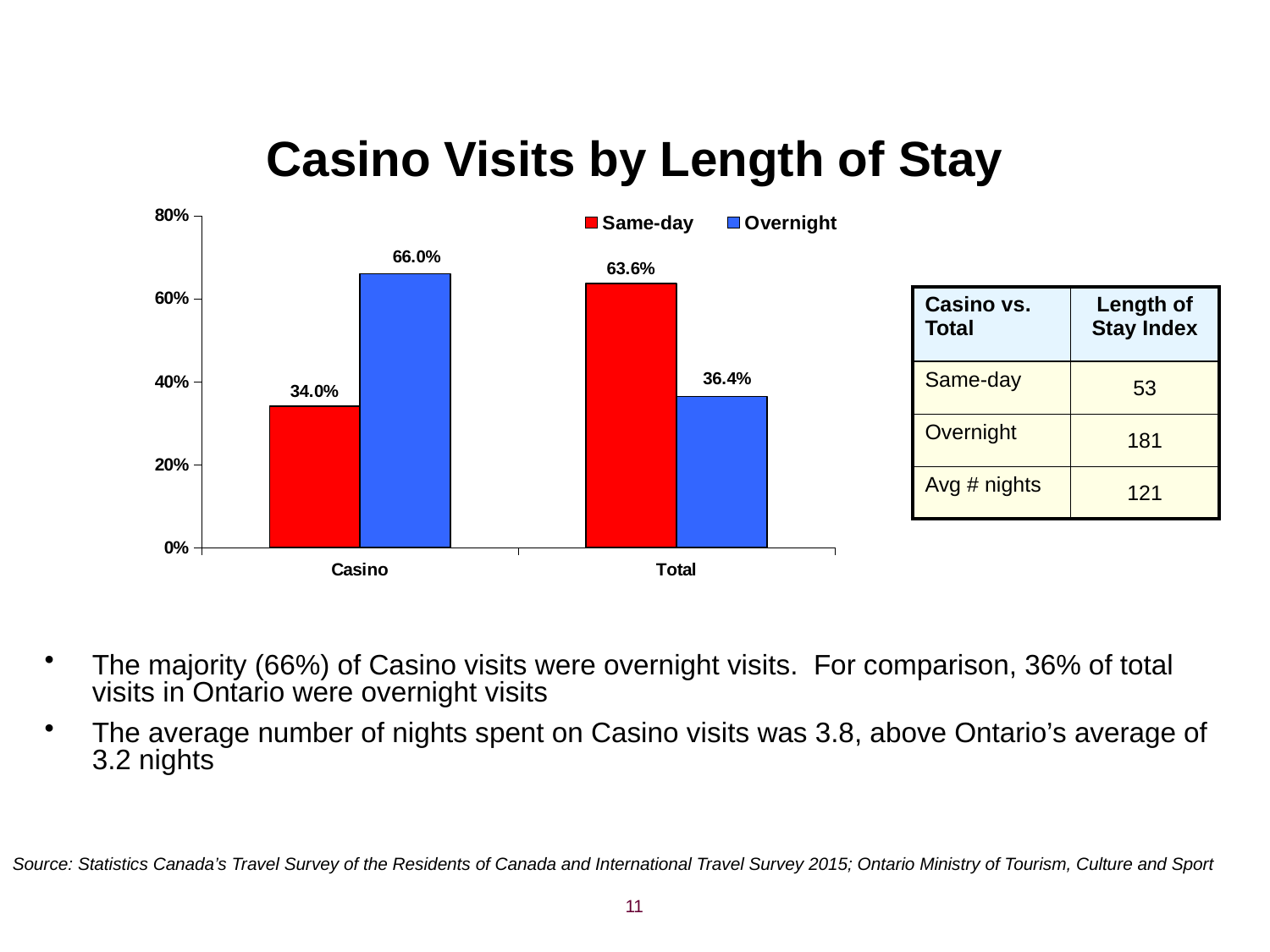
Which bar has the lowest value on the chart? Same-day for Casino Is the Same-day value for Total greater or less than 60%? greater What is the Overnight value for Total? 36.4% Which bar has the highest value on the chart? Overnight for Casino How many categories are shown on the x axis? 2 What kind of chart is shown? bar chart How many series does the legend list? 2 Which is larger for Total: Same-day or Overnight? Same-day What is the Overnight value for Casino? 66.0% What is the Same-day value for Total? 63.6% What is the Same-day value for Casino? 34.0% What is the difference between the Overnight and Same-day values for Casino? 32.0%